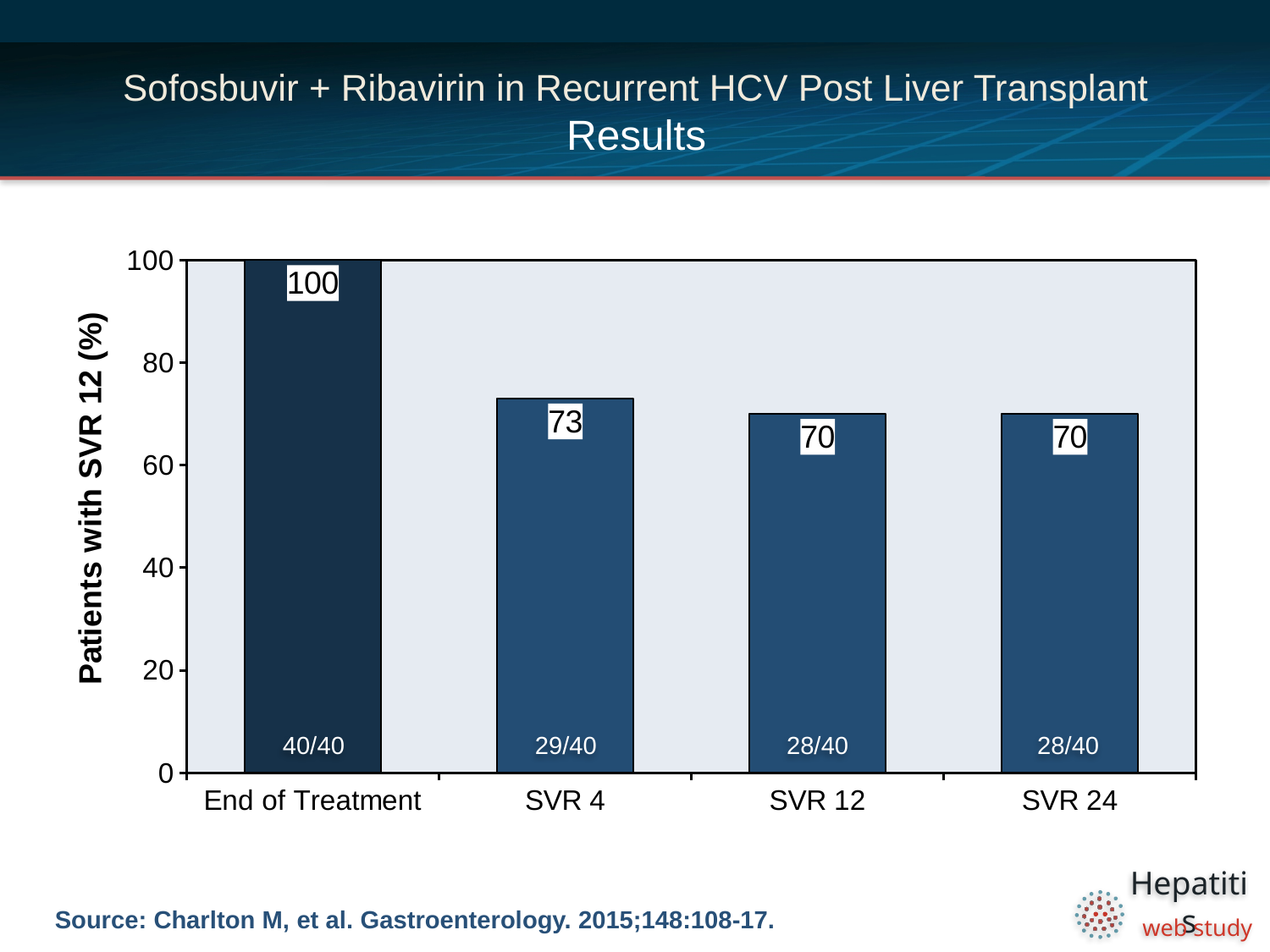
Is the value for SVR 4 greater or less than 80? less What is the difference between the SVR 4 value and the SVR 12 value? 3 How many categories are shown on the x axis? 4 What fraction of patients is shown inside the SVR 24 bar? 28/40 Which category has the highest value? End of Treatment What kind of chart is shown on the slide? bar chart What is the value for SVR 12? 70 What is the value for SVR 4? 73 Which is larger, the value for End of Treatment or the value for SVR 24? End of Treatment What is the value for End of Treatment? 100 What is the label of the y axis? Patients with SVR 12 (%) What is the difference between the End of Treatment value and the SVR 4 value? 27